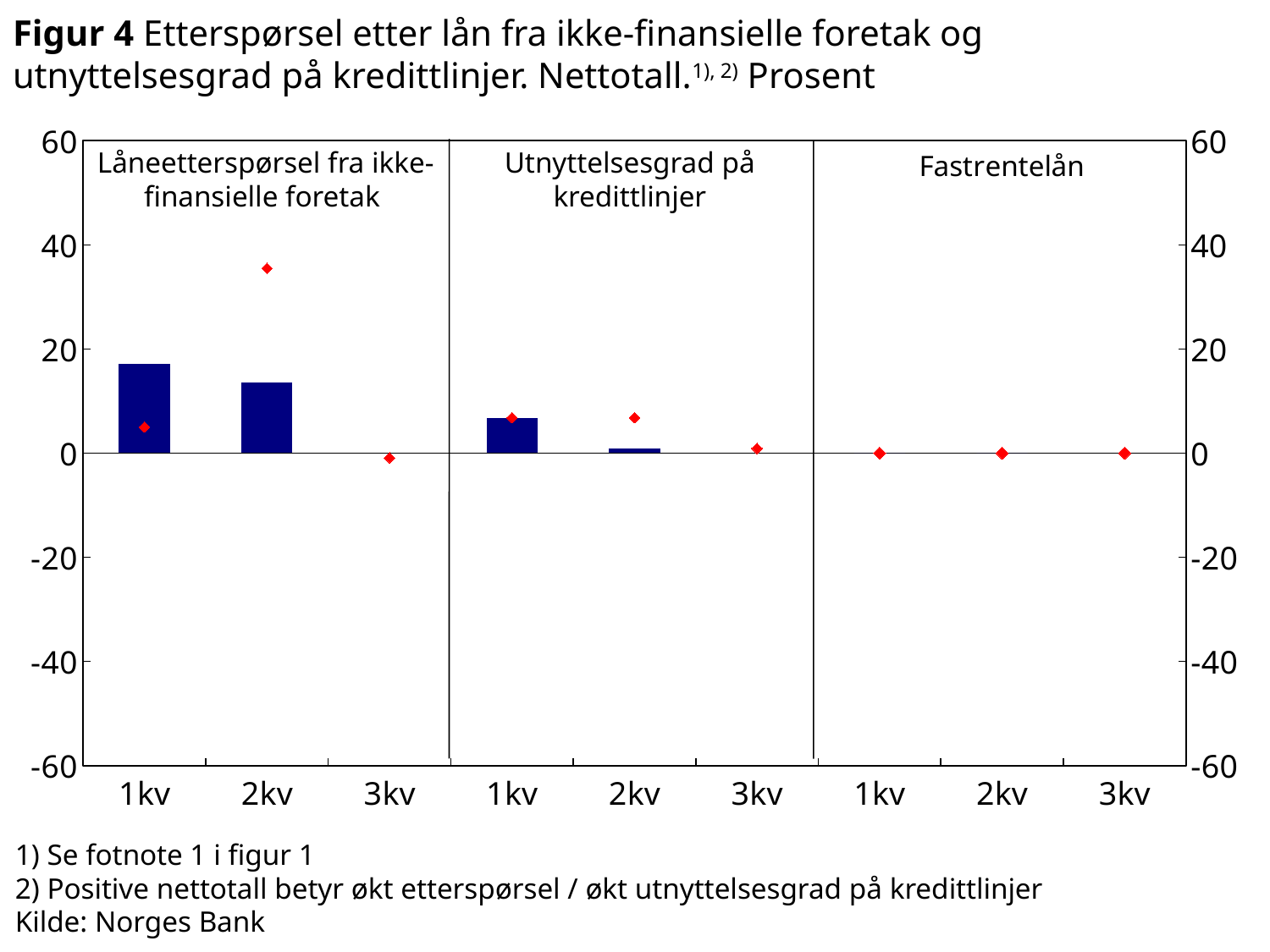
In the 'Utnyttelsesgrad på kredittlinjer' panel, which bar is taller, 1kv or 2kv? 1kv What kind of chart is shown on the slide? combination bar and line chart (bars with red diamond markers) What is the highest value shown on the vertical axis? 60 How many quarters are shown on the x axis within the 'Fastrentelån' panel? 3 In the 'Låneetterspørsel fra ikke-finansielle foretak' panel, is the bar for 1kv greater or less than 10? greater What is the source cited below the chart? Norges Bank In the 'Utnyttelsesgrad på kredittlinjer' panel, is the bar for 1kv greater or less than 20? less In the 'Låneetterspørsel fra ikke-finansielle foretak' panel, which quarter has the tallest bar? 1kv How many panels (sections) does the chart have? 3 In the 'Låneetterspørsel fra ikke-finansielle foretak' panel, do the bars rise or fall from 1kv to 2kv? fall In the 'Låneetterspørsel fra ikke-finansielle foretak' panel, is the bar for 1kv greater or less than 20? less